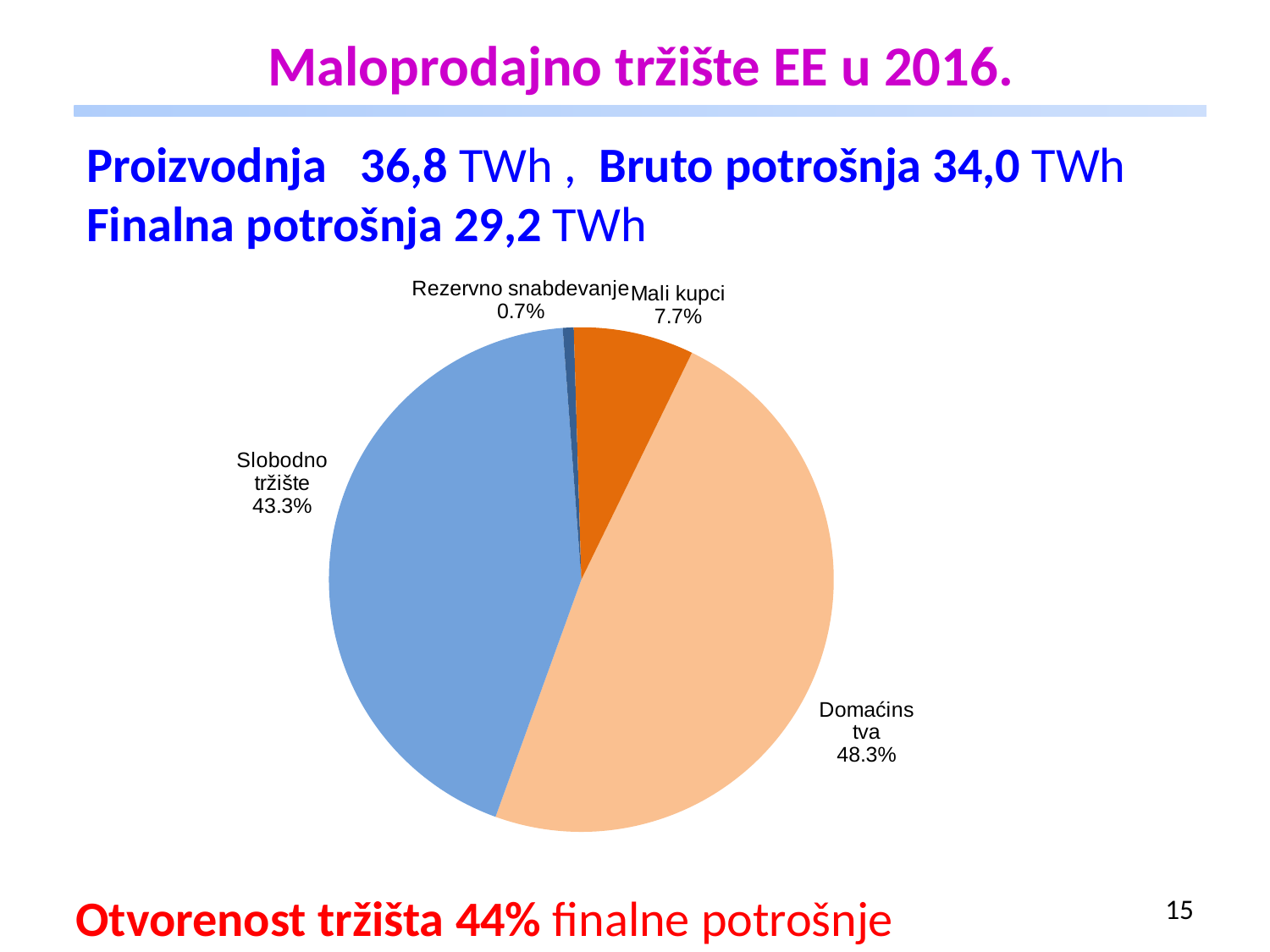
What share of the pie does Rezervno snabdevanje have? 0.7% What is the combined share of the Mali kupci and Rezervno snabdevanje slices? 8.4% What share of the pie does Slobodno tržište have? 43.3% Which slice of the pie is the largest? Domaćinstva What colour is the Slobodno tržište slice? light blue How many slices does the pie chart have? 4 What share of the pie does Domaćinstva have? 48.3% Which is larger, the Mali kupci slice or the Rezervno snabdevanje slice? Mali kupci What is the difference in percentage points between the Domaćinstva and Slobodno tržište slices? 5.0 percentage points What kind of chart is shown on the slide? pie chart Which slice of the pie is the smallest? Rezervno snabdevanje